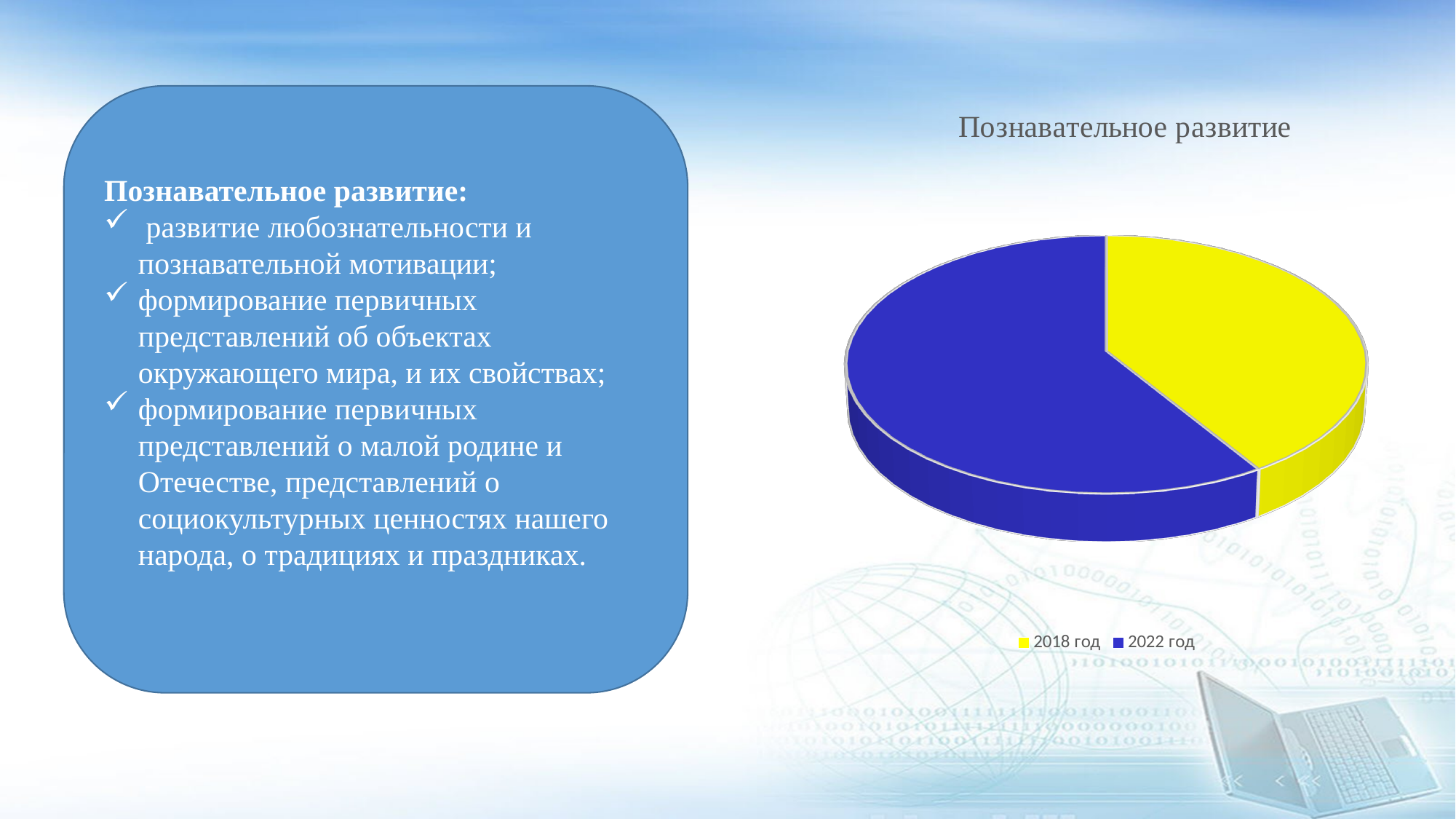
Which category has the largest slice of the pie? 2022 год What is the title of the chart? Познавательное развитие How many entries does the chart legend list? 2 What kind of chart is shown on the slide? Pie chart Does the slice for 2022 год take up more or less than half of the pie? more How many slices does the pie chart have? 2 What colour represents 2018 год in the pie chart? Yellow Which category has the smallest slice of the pie? 2018 год Which slice is larger, 2018 год or 2022 год? 2022 год Does the slice for 2018 год take up more or less than half of the pie? less